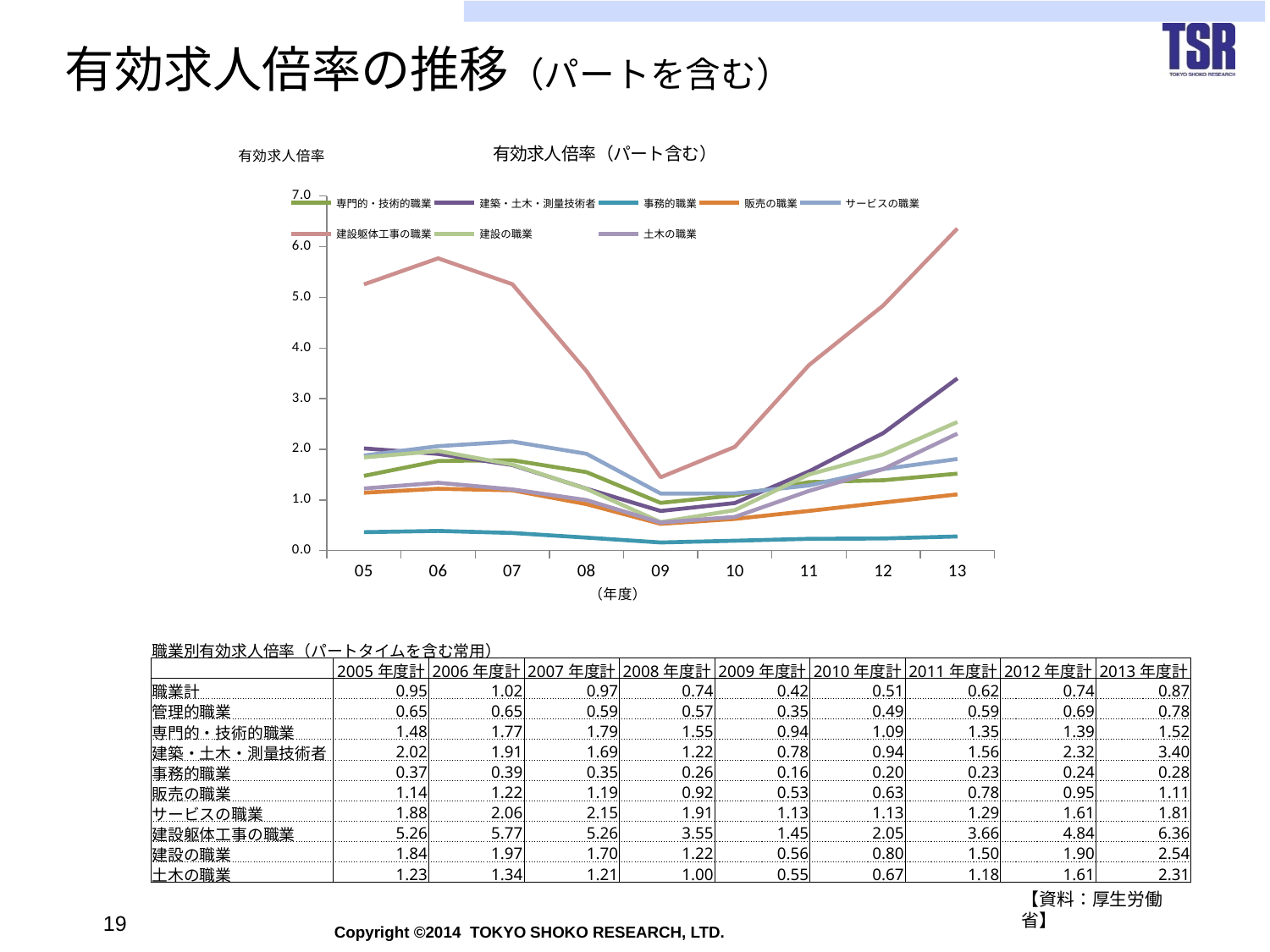
How many years are plotted along the x axis of the chart? 9 Using the table values, what is the difference between 建築・土木・測量技術者 in 2013年度 and 2012年度? 1.08 What kind of chart is shown on the slide? line chart Does the line for 建設躯体工事の職業 rise or fall from 09 to 13? rise Is the value for 事務的職業 in 09 greater or less than 1.0? less Which series has the highest value in 13 (2013年度)? 建設躯体工事の職業 In which year does 建設躯体工事の職業 reach its lowest point? 09 How many series does the chart legend list? 8 What is the value for 建設躯体工事の職業 in 2009年度 according to the table? 1.45 What is the title of the chart? 有効求人倍率（パート含む） Is the value for 建設躯体工事の職業 in 13 greater or less than 6.0? greater Which series has the lowest values across the whole chart? 事務的職業